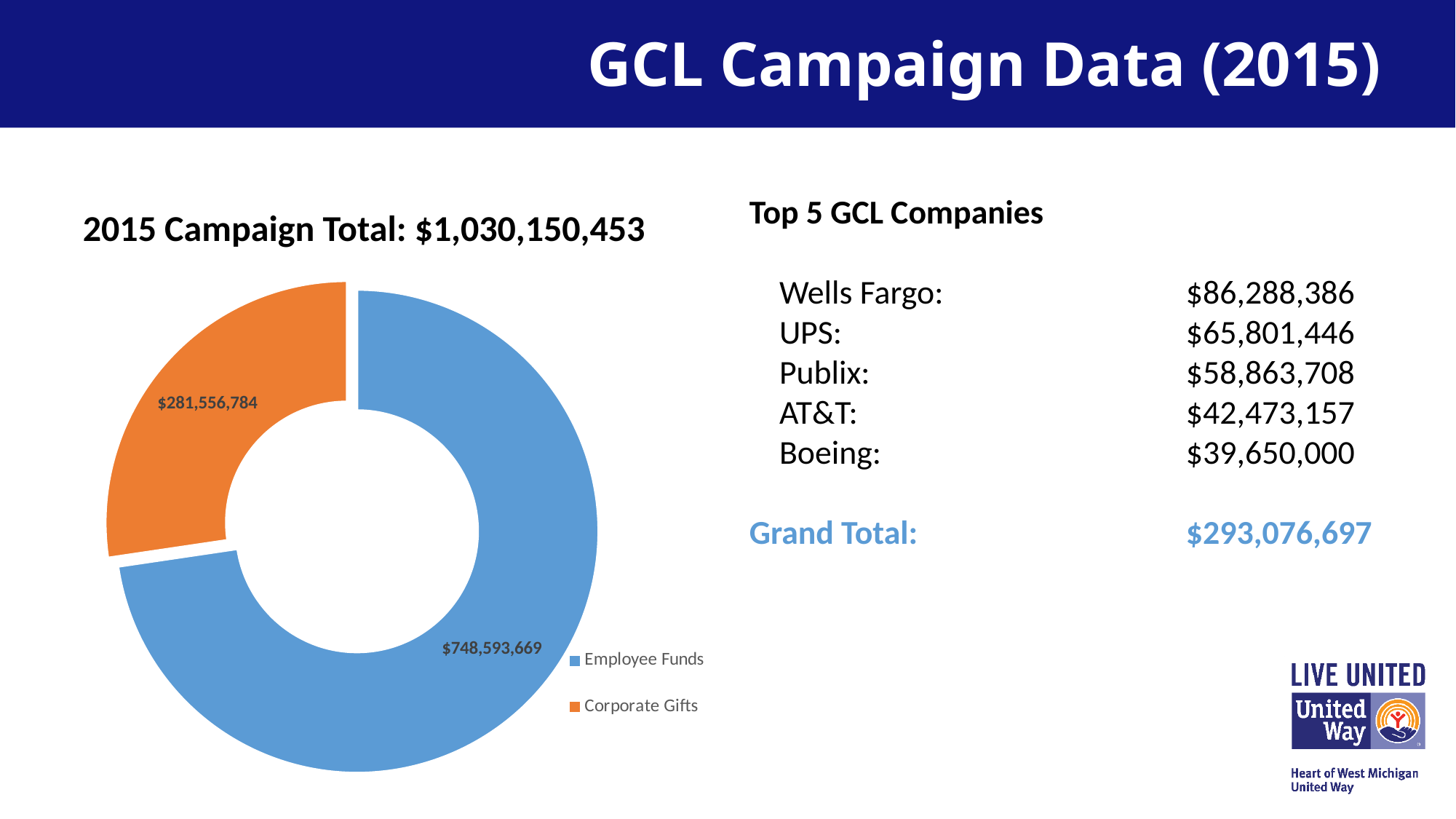
What is the value of the Corporate Gifts slice in the 2015 Campaign Total chart? $281,556,784 In the 2015 Campaign Total chart, which is larger: Employee Funds or Corporate Gifts? Employee Funds What is the combined total of the two slices in the 2015 Campaign Total chart? $1,030,150,453 What is the difference between Employee Funds and Corporate Gifts in the 2015 Campaign Total chart? $467,036,885 How many entries does the legend of the 2015 Campaign Total chart list? 2 What colour is the Corporate Gifts slice in the 2015 Campaign Total chart? Orange Which slice of the 2015 Campaign Total chart is the smallest? Corporate Gifts How many slices does the 2015 Campaign Total chart have? 2 Which slice of the 2015 Campaign Total chart is the largest? Employee Funds What is the value of the Employee Funds slice in the 2015 Campaign Total chart? $748,593,669 What kind of chart is used to show the 2015 Campaign Total? Doughnut chart What is the title of the chart on the left of the slide? 2015 Campaign Total: $1,030,150,453